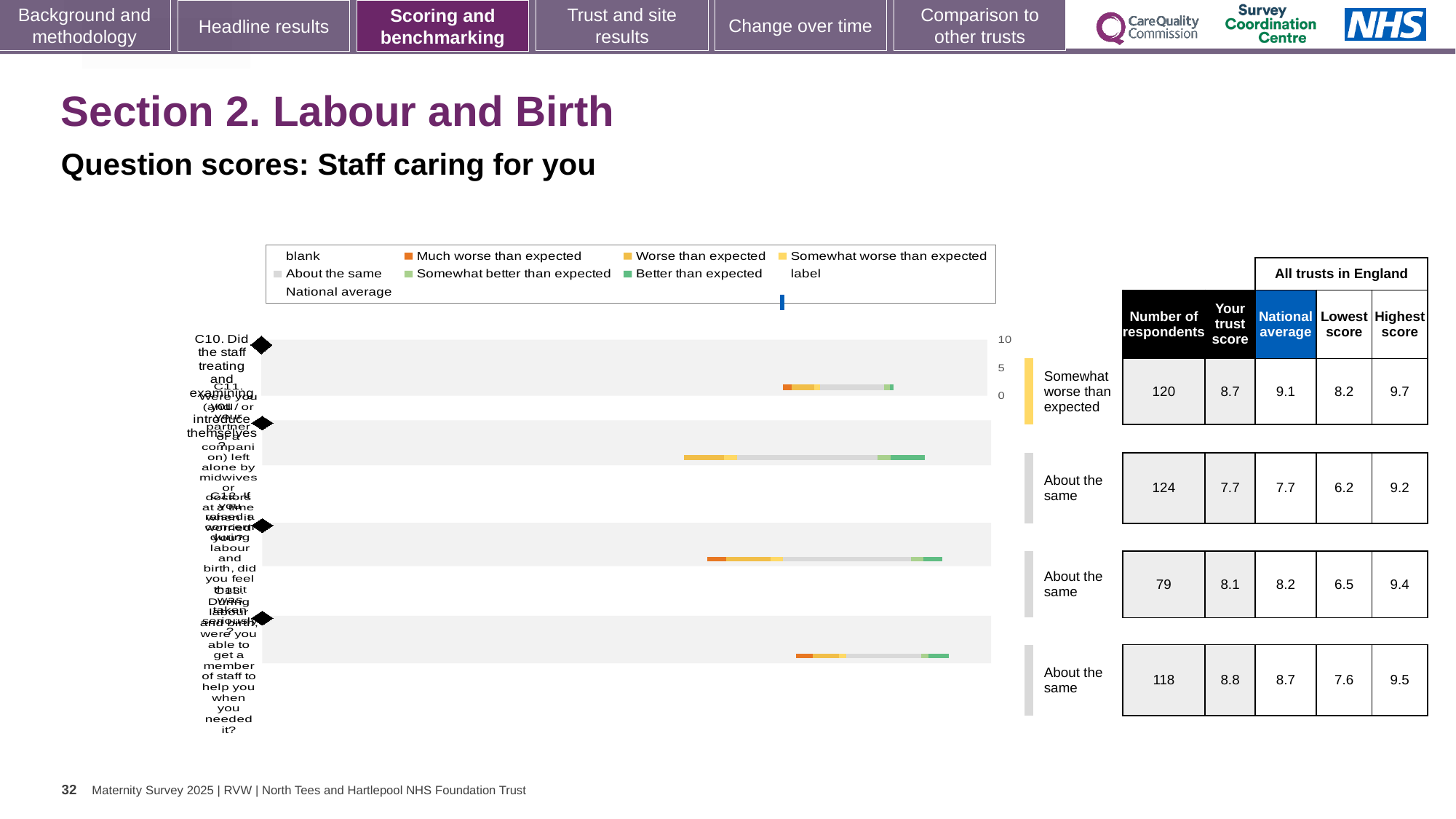
In the table beside the chart, what is 'Your trust score' for the row labelled 'Somewhat worse than expected'? 8.7 What colour is used in the legend for 'Better than expected'? green In the table beside the chart, what is the national average for the second row from the top? 7.7 Which row in the table has the highest number of respondents? the second row (124) How many entries does the chart legend list? 9 What kind of chart is shown on the slide? bar chart In the table beside the chart, what is the number of respondents for the row labelled 'Somewhat worse than expected'? 120 What is the lowest 'Your trust score' value shown in the table? 7.7 How many question rows (bars) are plotted in the chart? 4 In the table beside the chart, what is the highest score for the bottom row? 9.5 For the row labelled 'Somewhat worse than expected', what is the difference between the national average and your trust score? 0.4 For the row labelled 'Somewhat worse than expected', which is larger: your trust score or the national average? national average